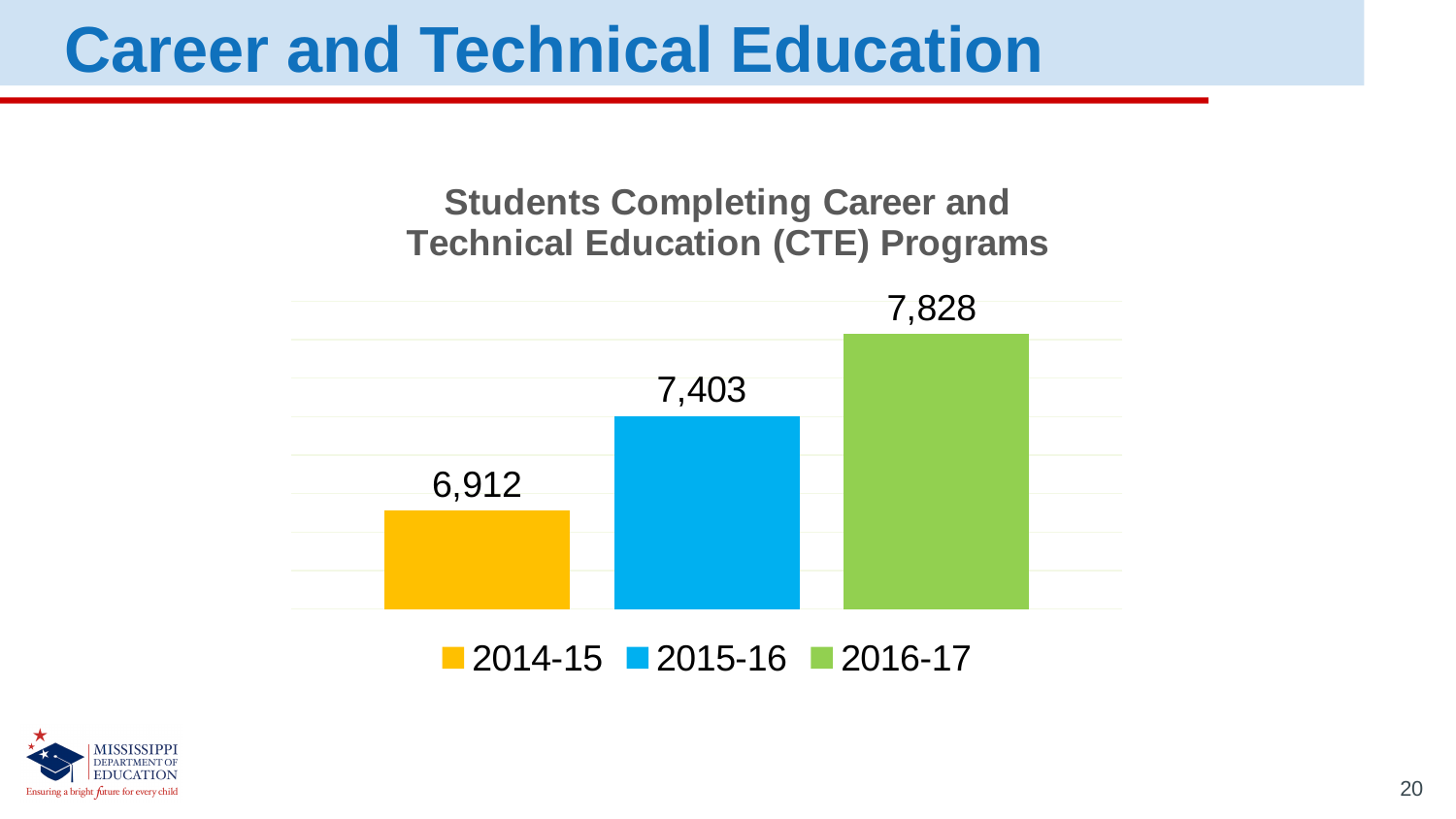
Which year has the lowest number of students completing CTE programs? 2014-15 How many entries does the legend list? 3 What is the difference between the values for 2015-16 and 2014-15? 491 What is the value for 2014-15? 6,912 What is the value for 2015-16? 7,403 What is the value for 2016-17? 7,828 What is the difference between the values for 2016-17 and 2014-15? 916 Which is larger, the value for 2015-16 or the value for 2016-17? 2016-17 Which year has the highest number of students completing CTE programs? 2016-17 Do the values rise or fall from 2014-15 to 2016-17? Rise How many bars are shown in the chart? 3 What kind of chart is shown on the slide? Bar chart